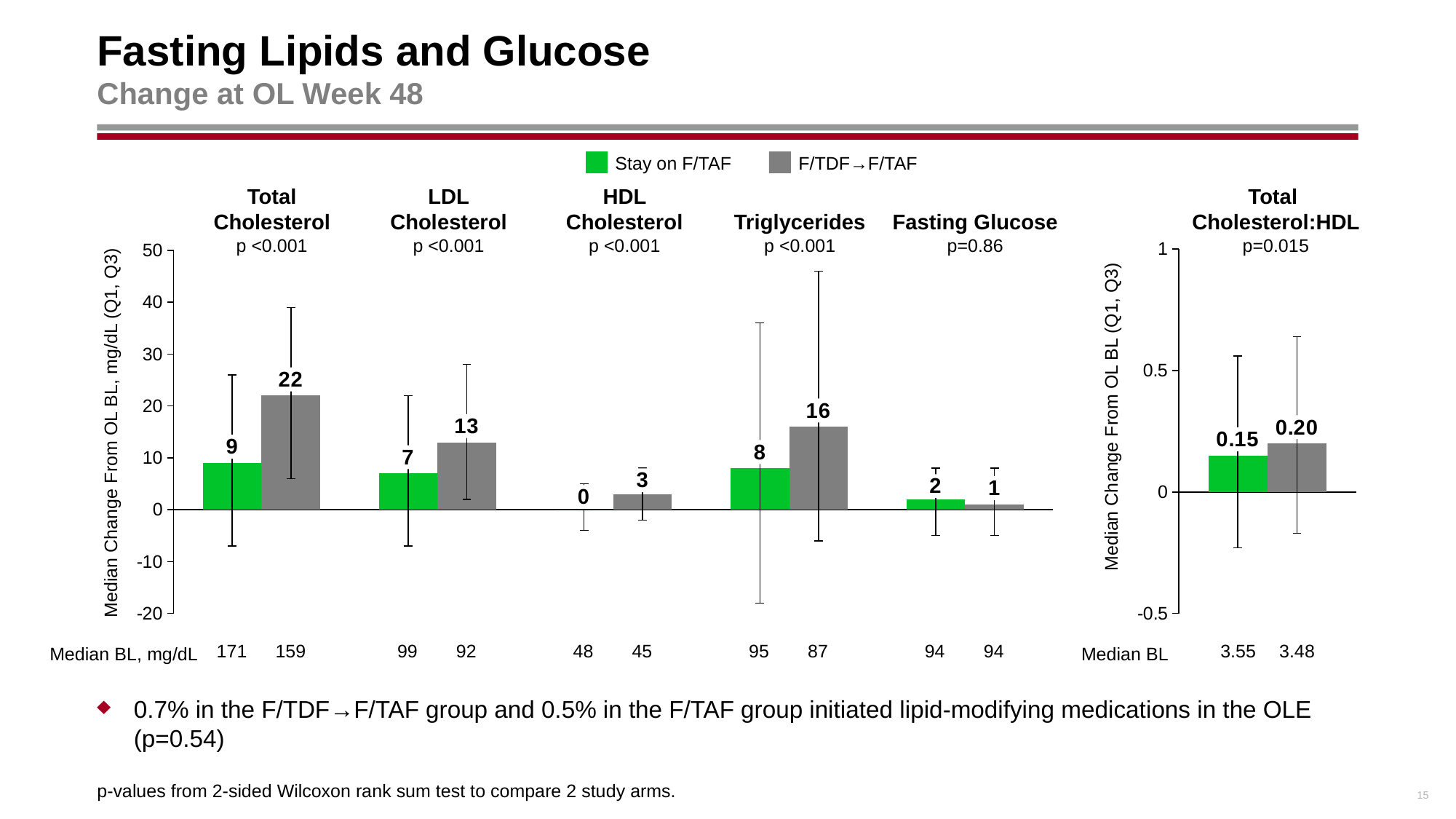
In the left chart, which category has the highest median change for the F/TDF→F/TAF group? Total Cholesterol In the Total Cholesterol:HDL chart, what is the difference between the F/TDF→F/TAF and Stay on F/TAF median changes? 0.05 In the left chart, what is the median change in LDL Cholesterol for the Stay on F/TAF group? 7 In the Total Cholesterol:HDL chart, what is the median change for the F/TDF→F/TAF group? 0.20 How many categories are shown on the x axis of the left chart? 5 What kind of chart is used on this slide? Bar chart How many series does the legend list? 2 What p-value is shown for Fasting Glucose in the left chart? p=0.86 In the left chart, what is the difference between the F/TDF→F/TAF and Stay on F/TAF median changes for Triglycerides? 8 In the left chart, which group has the larger median change in Fasting Glucose, Stay on F/TAF or F/TDF→F/TAF? Stay on F/TAF In the left chart, what is the median change in Total Cholesterol for the F/TDF→F/TAF group? 22 In the left chart, what is the median change in HDL Cholesterol for the Stay on F/TAF group? 0